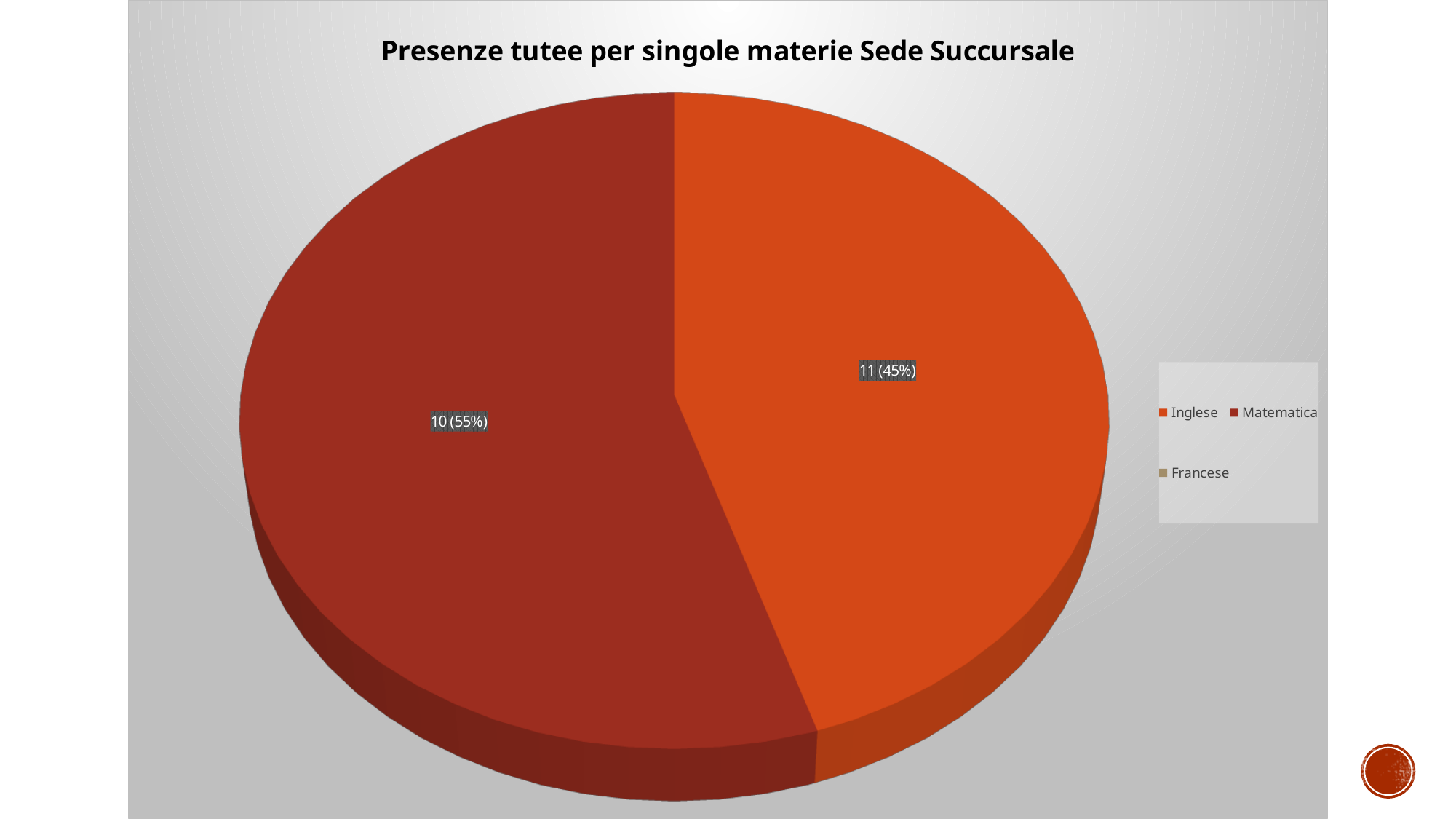
What data label is shown on the Matematica slice? 10 (55%) What percentage share of the pie is labelled for Matematica? 55% Which category is shown in orange in the legend? Inglese How many categories does the legend list? 3 What data label is shown on the Inglese slice? 11 (45%) Which legend entry has no visible slice in the pie? Francese What kind of chart is shown on the slide? pie chart What is the title of the chart? Presenze tutee per singole materie Sede Succursale What percentage share of the pie is labelled for Inglese? 45%